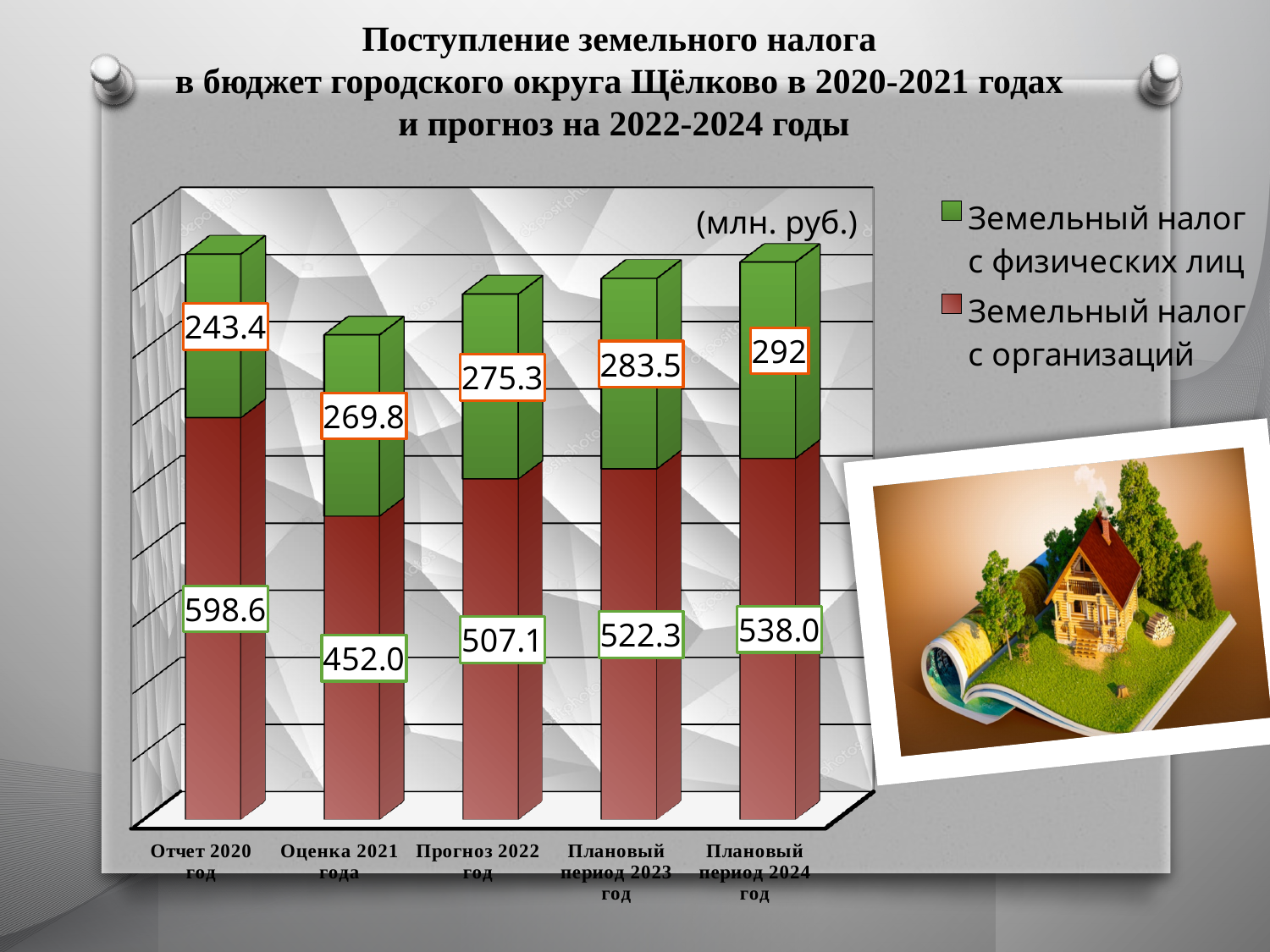
Which category has the highest value for 'Земельный налог с организаций'? Отчет 2020 год What is the value of 'Земельный налог с физических лиц' for 'Плановый период 2024 год'? 292 Which is larger: 'Земельный налог с физических лиц' for 'Прогноз 2022 год' or for 'Плановый период 2023 год'? Плановый период 2023 год What unit is indicated in the chart area? млн. руб. How many series does the legend list? 2 What is the value of 'Земельный налог с организаций' for 'Отчет 2020 год'? 598.6 What is the value of 'Земельный налог с организаций' for 'Оценка 2021 года'? 452.0 What is the total of the stacked bar for 'Плановый период 2024 год'? 830.0 How many categories are shown on the x axis? 5 What kind of chart is shown on the slide? Stacked bar chart Which category has the lowest value for 'Земельный налог с физических лиц'? Отчет 2020 год What is the difference between 'Земельный налог с организаций' for 'Отчет 2020 год' and 'Оценка 2021 года'? 146.6